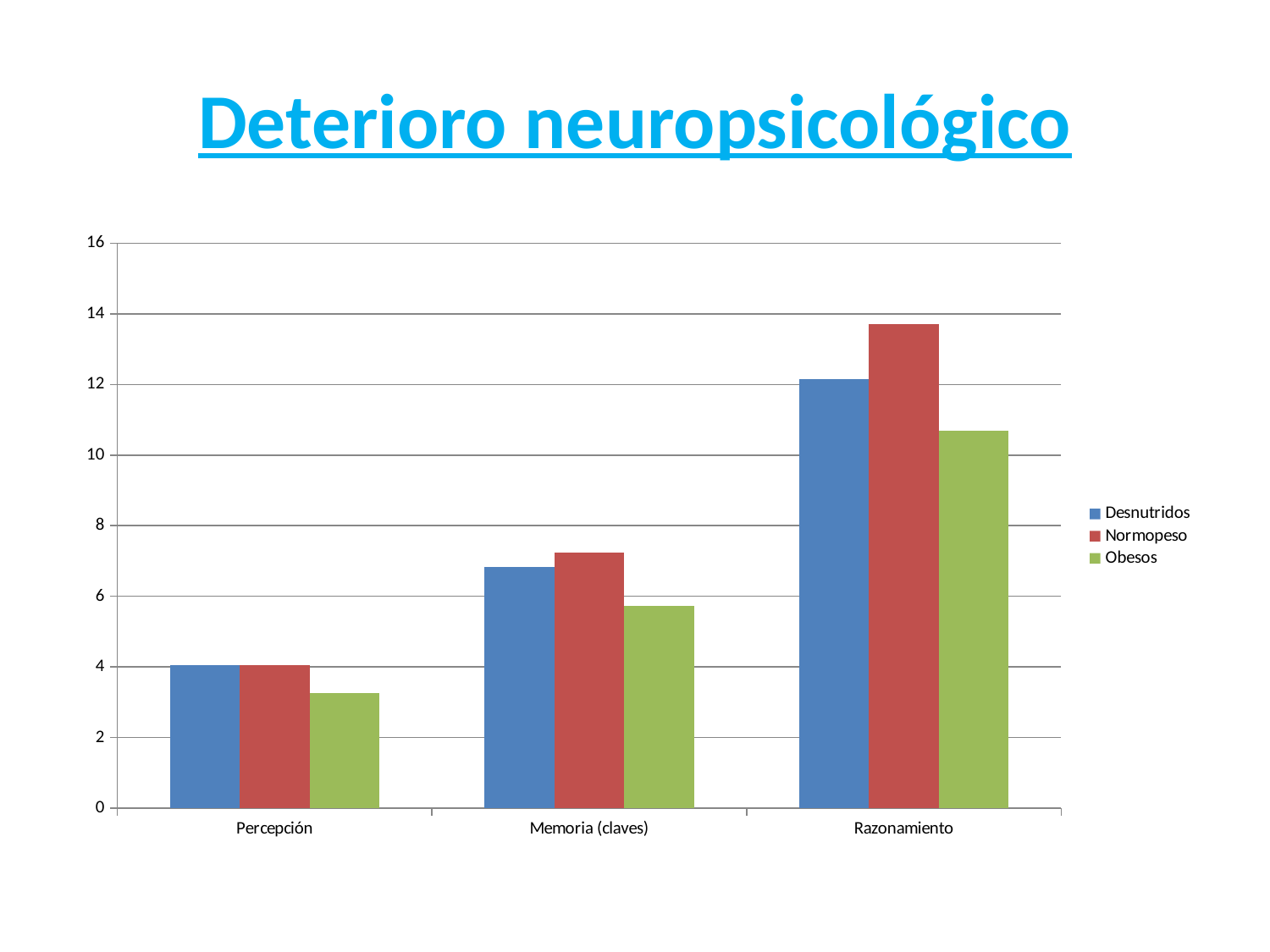
In which category is the Obesos bar lowest? Percepción Is the value for Obesos in Razonamiento greater or less than 12? less Is the value for Obesos in Percepción greater or less than 4? less In Razonamiento, which is larger: Normopeso or Obesos? Normopeso How many categories are shown on the x axis? 3 Is the value for Normopeso in Memoria (claves) greater or less than 8? less Which series is shown in green in the legend? Obesos How many series does the legend list? 3 What kind of chart is shown on the slide? bar chart What is the title of the slide containing the chart? Deterioro neuropsicológico In which category is the Normopeso bar highest? Razonamiento